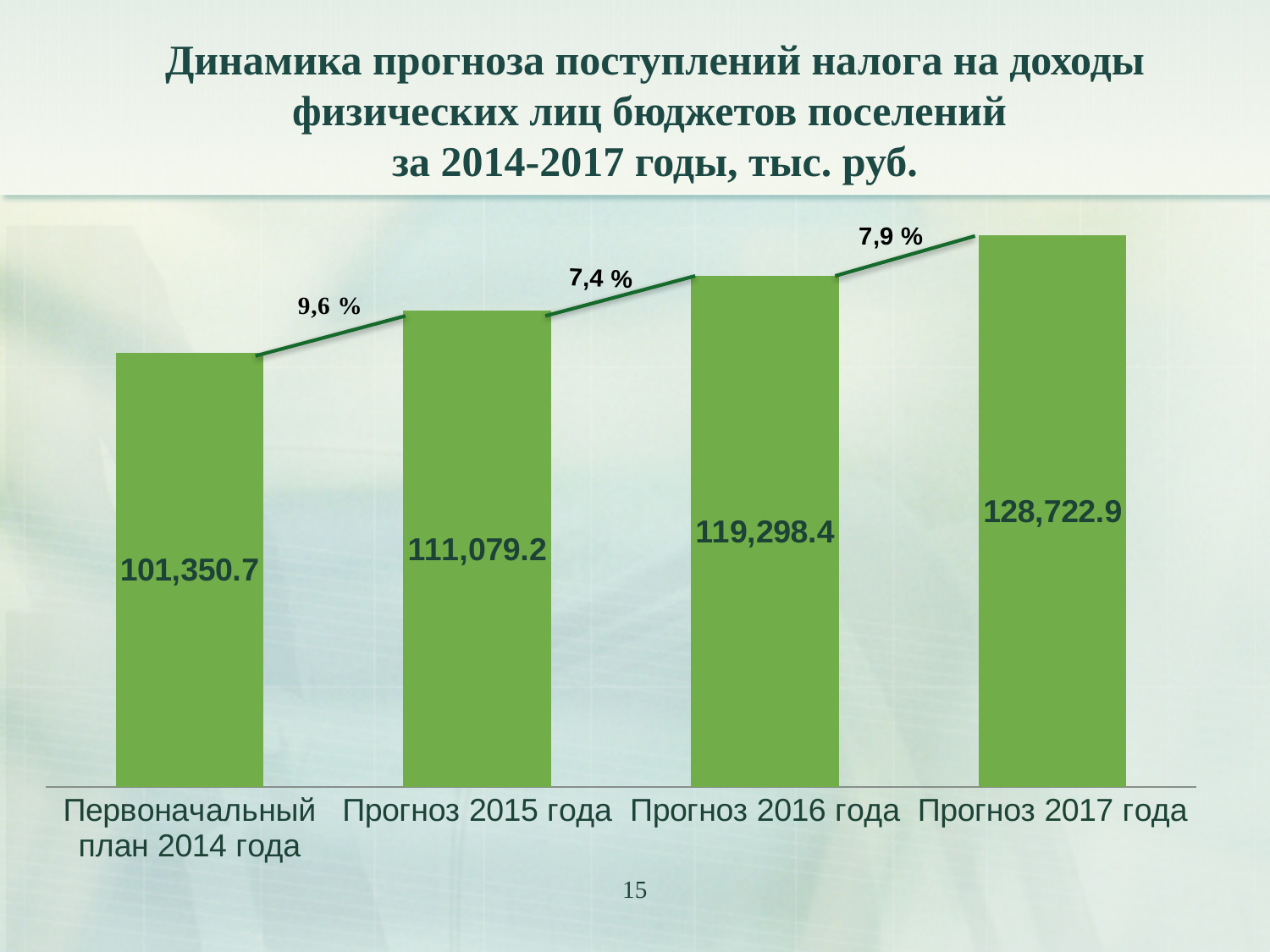
Which category has the highest value? Прогноз 2017 года What is the difference between the values for Прогноз 2016 года and Прогноз 2015 года? 8,219.2 What kind of chart is shown on the slide? Bar chart What is the value for Прогноз 2017 года? 128,722.9 What is the value for Первоначальный план 2014 года? 101,350.7 How many bars are shown in the chart? 4 What is the difference between the values for Прогноз 2017 года and Первоначальный план 2014 года? 27,372.2 What is the value for Прогноз 2015 года? 111,079.2 What percentage growth is annotated between Прогноз 2016 года and Прогноз 2017 года? 7,9 % Do the values rise or fall from left to right along the x axis? Rise Which is larger, the value for Прогноз 2016 года or Прогноз 2015 года? Прогноз 2016 года Which category has the lowest value? Первоначальный план 2014 года